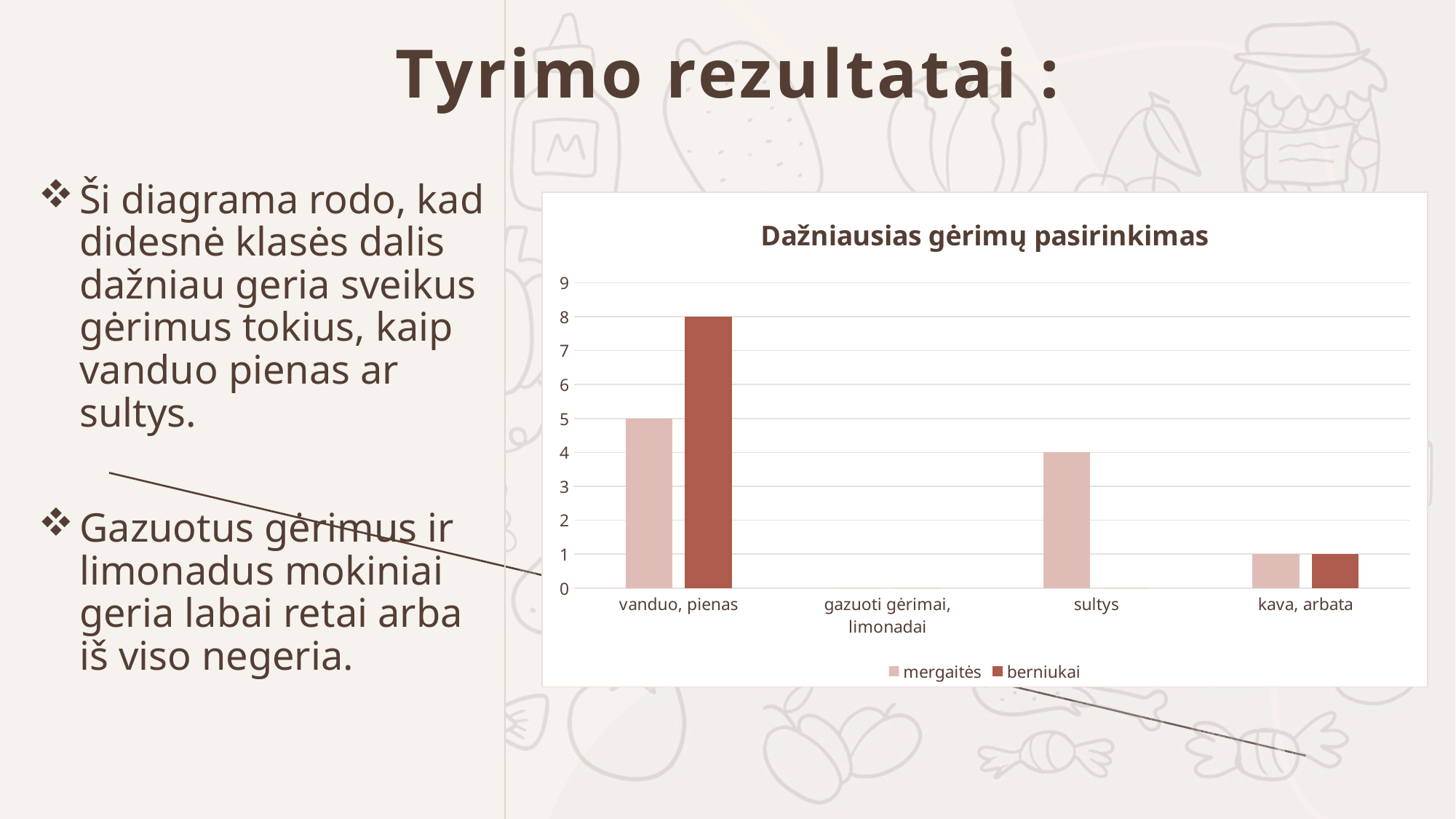
How many series does the legend list? 2 What is the title of the chart? Dažniausias gėrimų pasirinkimas How many categories are shown on the x axis? 4 What is the difference between the berniukai and mergaitės values for vanduo, pienas? 3 What kind of chart is shown on the slide? bar chart Is the value for berniukai in vanduo, pienas greater or less than 6? greater What is the value for berniukai in the category vanduo, pienas? 8 Which category has the highest value for berniukai? vanduo, pienas What is the value for mergaitės in the category sultys? 4 What is the value for mergaitės in the category vanduo, pienas? 5 Which category has the lowest value for mergaitės? gazuoti gėrimai, limonadai What is the value for berniukai in the category kava, arbata? 1